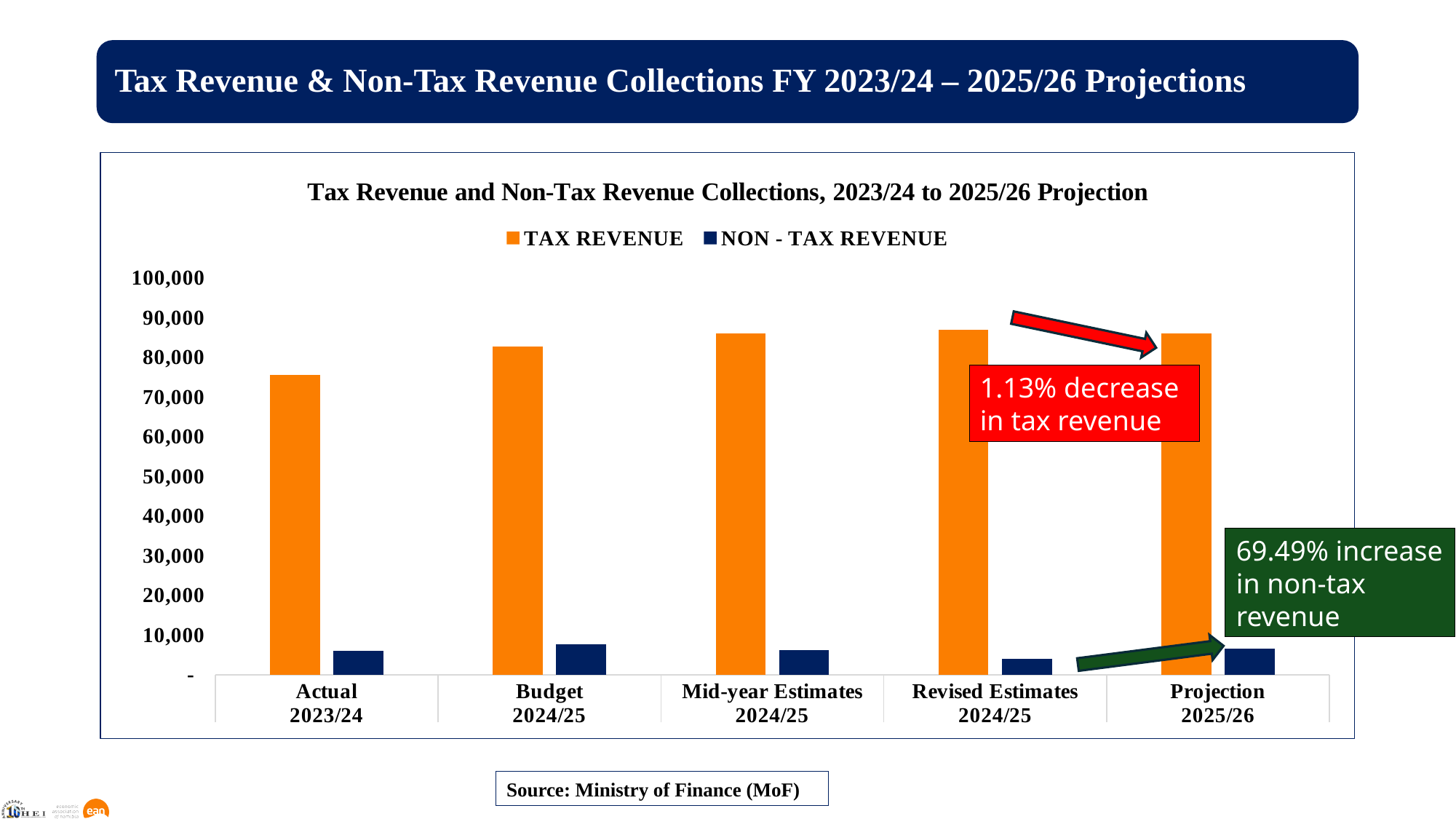
Does TAX REVENUE rise or fall from Actual 2023/24 to Revised Estimates 2024/25? Rise Is the TAX REVENUE value for Actual 2023/24 greater or less than 80,000? less How many categories are shown along the x axis of the chart? 5 Which colour represents TAX REVENUE in the chart legend? Orange Is the TAX REVENUE value for Budget 2024/25 greater or less than 80,000? greater Is the NON - TAX REVENUE value for Budget 2024/25 greater or less than 10,000? less Which category has the highest NON - TAX REVENUE bar? Budget 2024/25 Which category has the lowest NON - TAX REVENUE bar? Revised Estimates 2024/25 Which is larger: TAX REVENUE for Actual 2023/24 or TAX REVENUE for Budget 2024/25? Budget 2024/25 What kind of chart is shown on the slide? Bar chart Which category has the lowest TAX REVENUE bar? Actual 2023/24 How many series does the chart legend list? 2